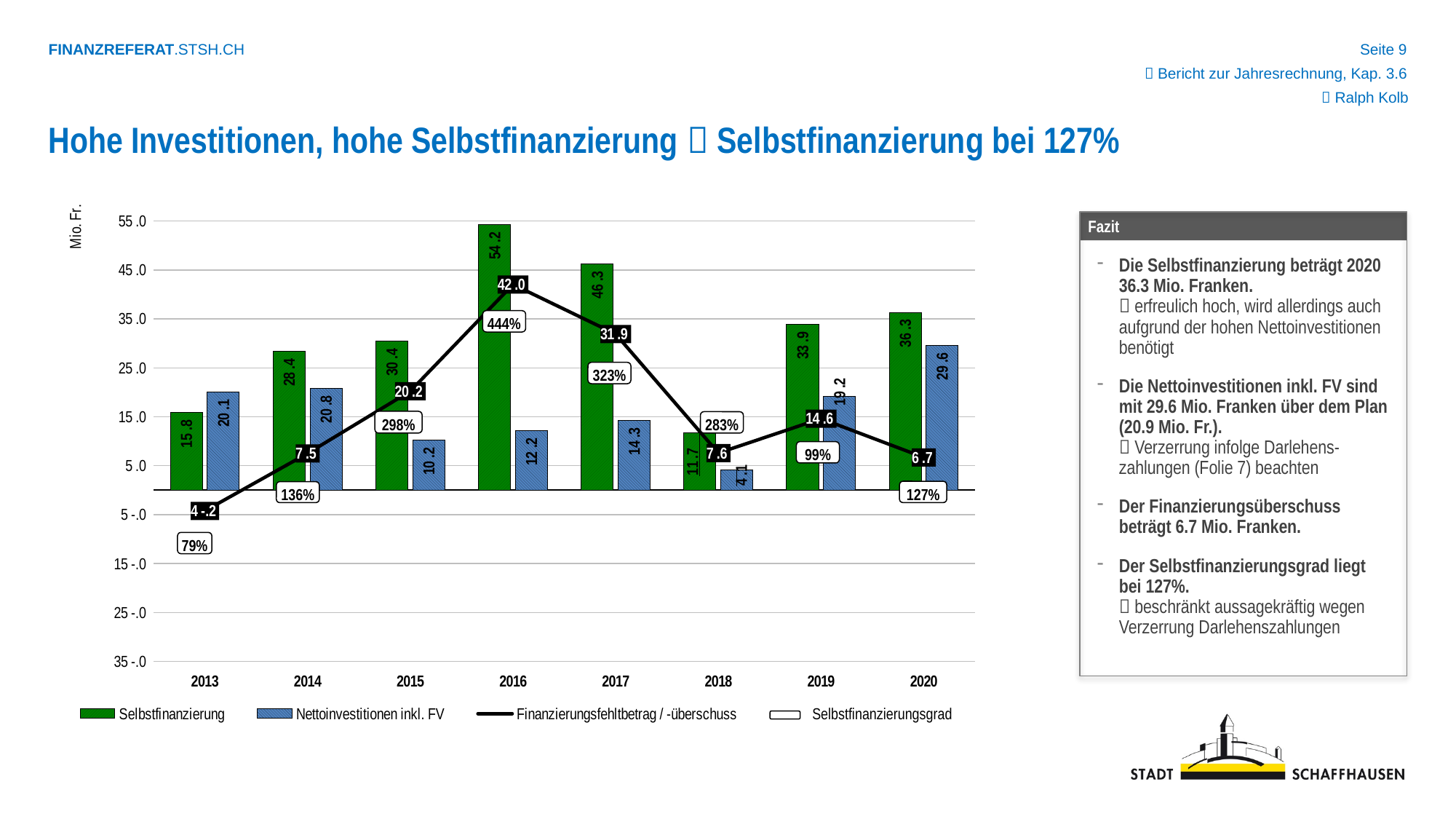
In which year is Selbstfinanzierung highest? 2016 What is the difference between Selbstfinanzierung and Nettoinvestitionen inkl. FV in 2017? 32.0 How many years are shown on the x axis? 8 What is the Selbstfinanzierung value for 2020? 36.3 How many series does the legend list? 4 What kind of chart is shown on the slide? Combined bar and line chart Which is larger in 2013, Selbstfinanzierung or Nettoinvestitionen inkl. FV? Nettoinvestitionen inkl. FV What is the Finanzierungsfehlbetrag / -überschuss value for 2013? -4.2 In which year is Nettoinvestitionen inkl. FV lowest? 2018 What unit is shown on the y axis label? Mio. Fr. What is the Nettoinvestitionen inkl. FV value for 2019? 19.2 What is the Selbstfinanzierungsgrad for 2016? 444%